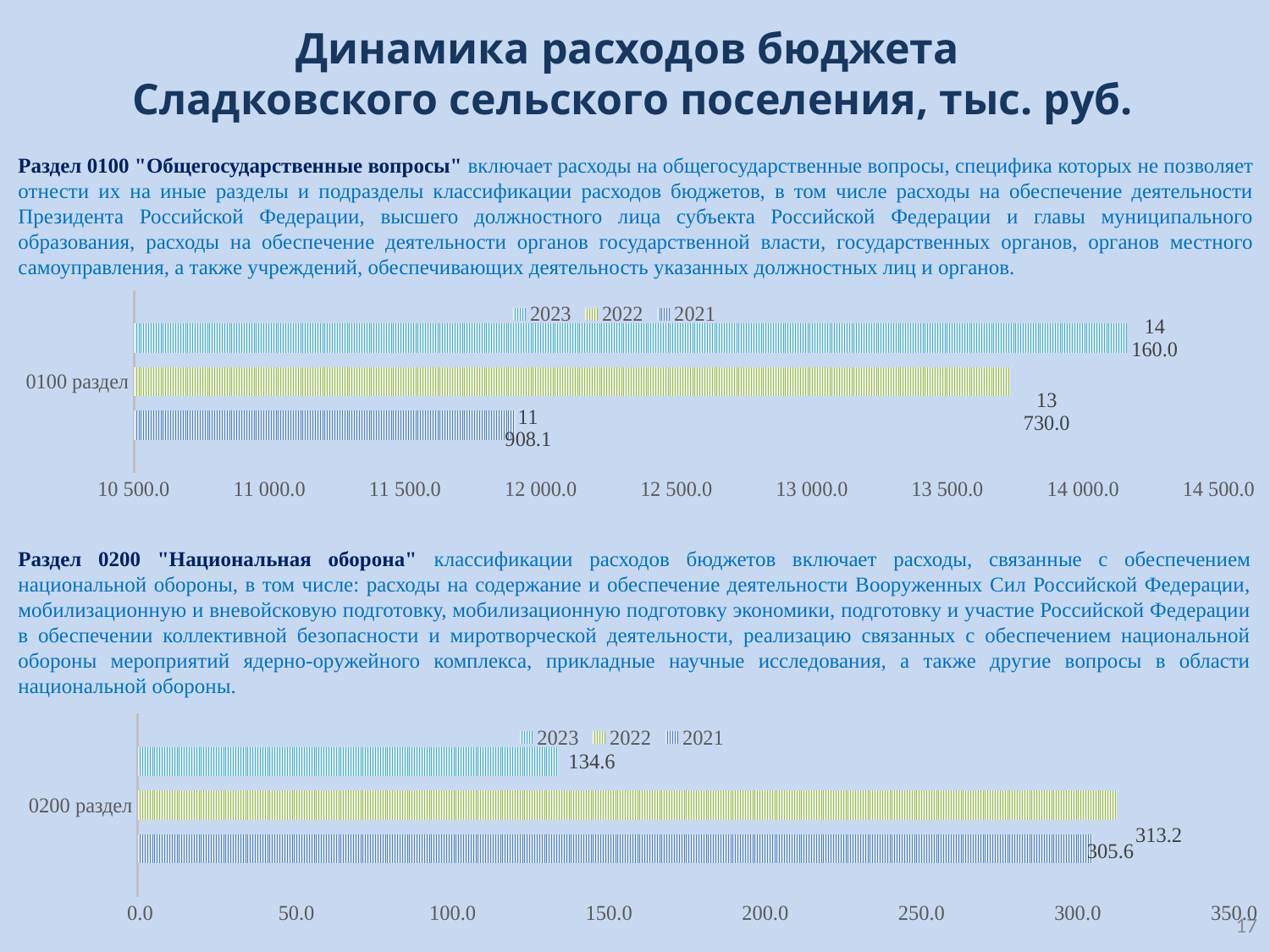
In the top chart (0100 раздел), which year has the lowest value? 2021 In the bottom chart (0200 раздел), what is the value for 2023? 134.6 In the bottom chart (0200 раздел), is the value for 2022 larger than the value for 2021? Yes In the top chart (0100 раздел), what is the value for 2022? 13 730.0 In the bottom chart (0200 раздел), what is the value for 2022? 313.2 In the top chart (0100 раздел), what is the difference between the 2023 and 2022 values? 430.0 What kind of chart is the top chart (0100 раздел)? Bar chart In the top chart (0100 раздел), what is the value for 2021? 11 908.1 In the top chart (0100 раздел), which year has the highest value? 2023 How many series does the legend of the bottom chart (0200 раздел) list? 3 In the bottom chart (0200 раздел), which year has the lowest value? 2023 In the top chart (0100 раздел), what is the value for 2023? 14 160.0